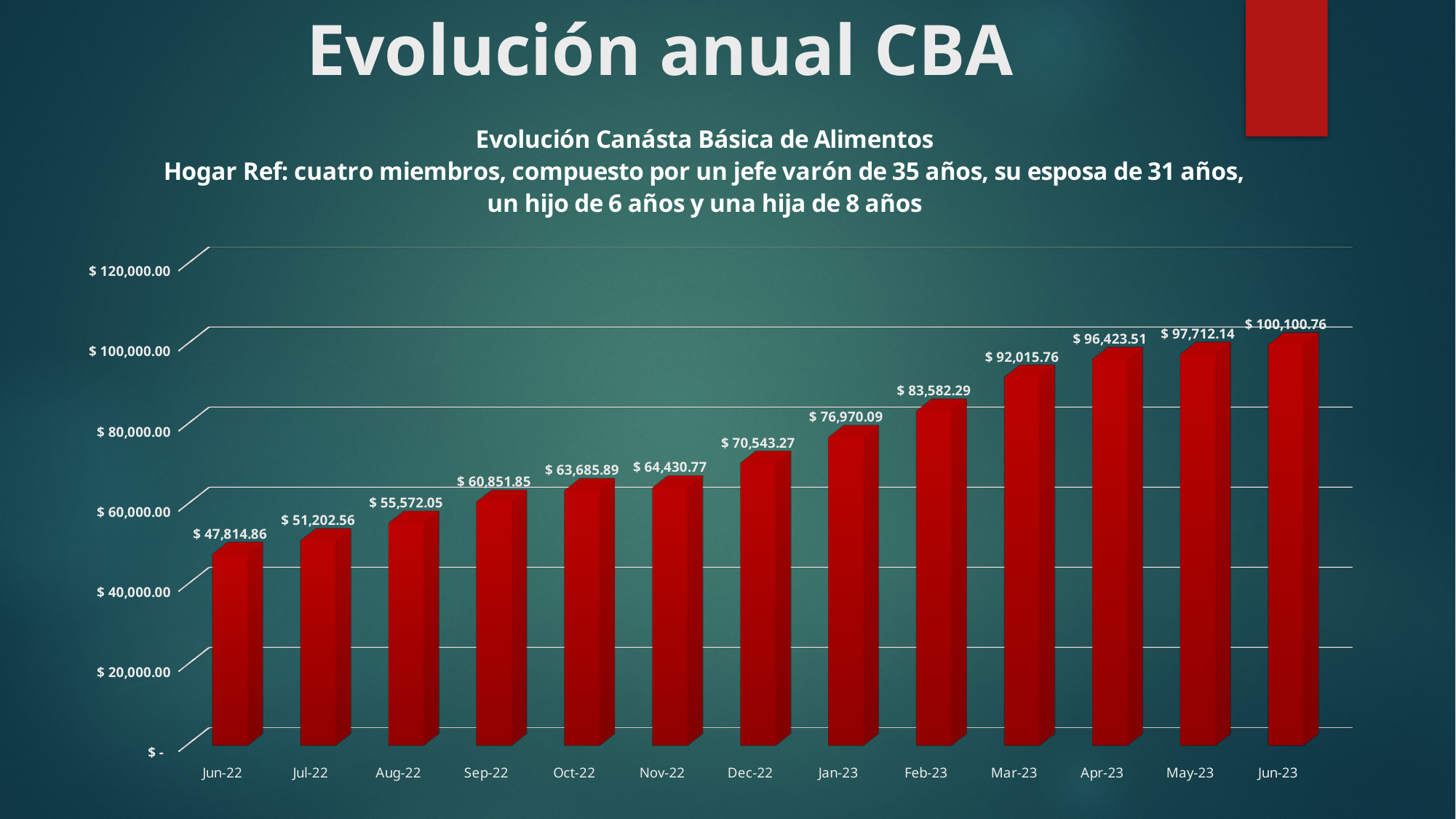
Which is larger, the value for Sep-22 or the value for Feb-23? Feb-23 Which month has the lowest value? Jun-22 What is the value for Jun-22? $ 47,814.86 What is the value for Dec-22? $ 70,543.27 What is the value for Mar-23? $ 92,015.76 Which month has the highest value? Jun-23 Do the values rise or fall from Jun-22 to Jun-23? Rise What kind of chart is shown on the slide? Bar chart What is the difference between the values for Dec-22 and Nov-22? $ 6,112.50 What is the difference between the values for Jun-23 and Jun-22? $ 52,285.90 Is the value for Jan-23 greater or less than 80,000? less How many months are shown on the x axis? 13